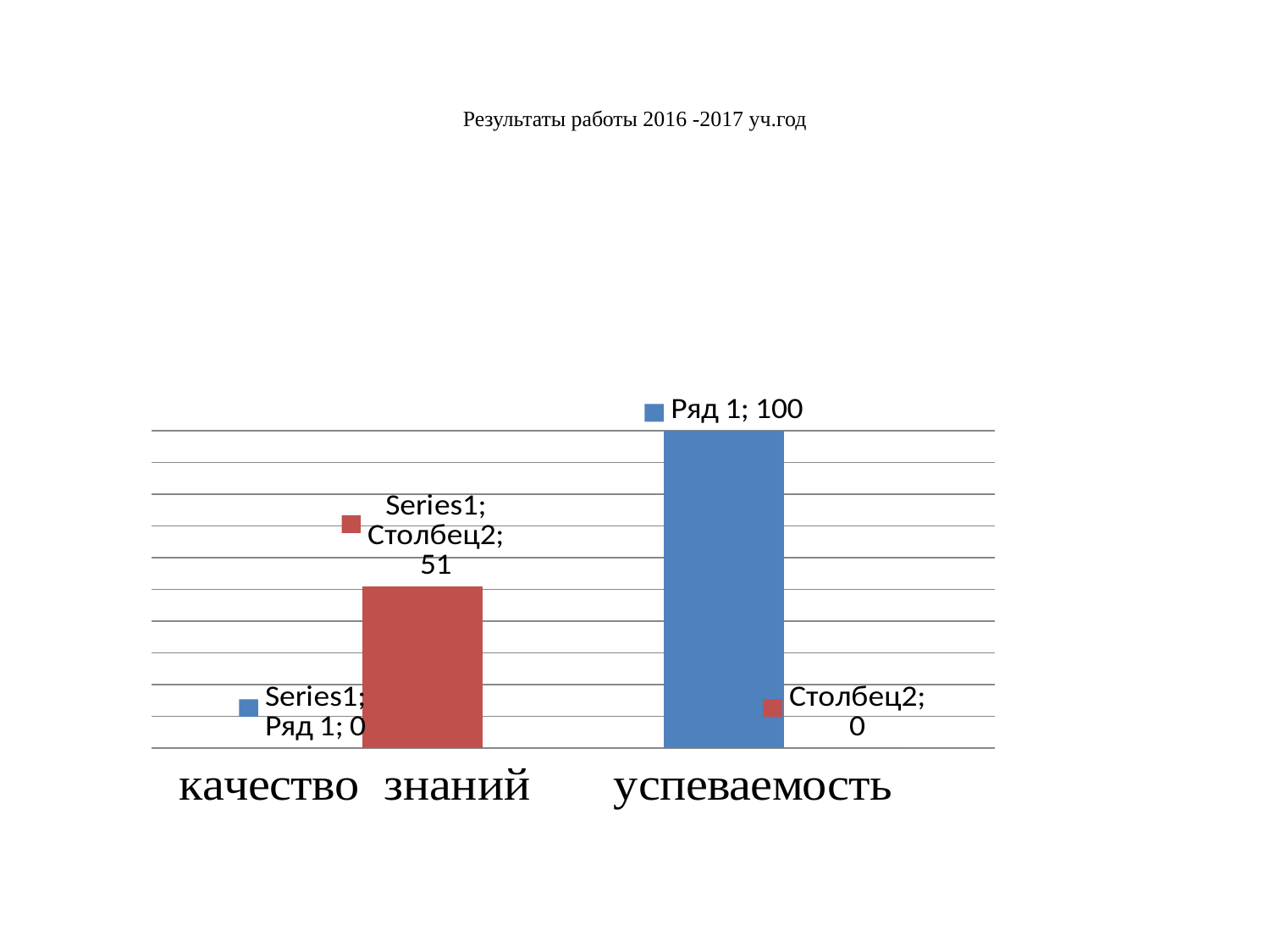
Which is larger: the Ряд 1 value for успеваемость or the Столбец2 value for качество знаний? Ряд 1 value for успеваемость What is the value of Ряд 1 for успеваемость? 100 What kind of chart is shown on the slide? bar chart Which category has the highest plotted value in the chart? успеваемость What colour is the bar for Ряд 1 in the успеваемость category? blue What is the value of Ряд 1 for качество знаний? 0 What is the total of the two series values for качество знаний? 51 What is the value of Столбец2 for качество знаний? 51 What is the title of the chart? Результаты работы 2016 -2017 уч.год What is the difference between the Ряд 1 value for успеваемость and the Столбец2 value for качество знаний? 49 What is the value of Столбец2 for успеваемость? 0 How many categories are shown on the x axis of the chart? 2